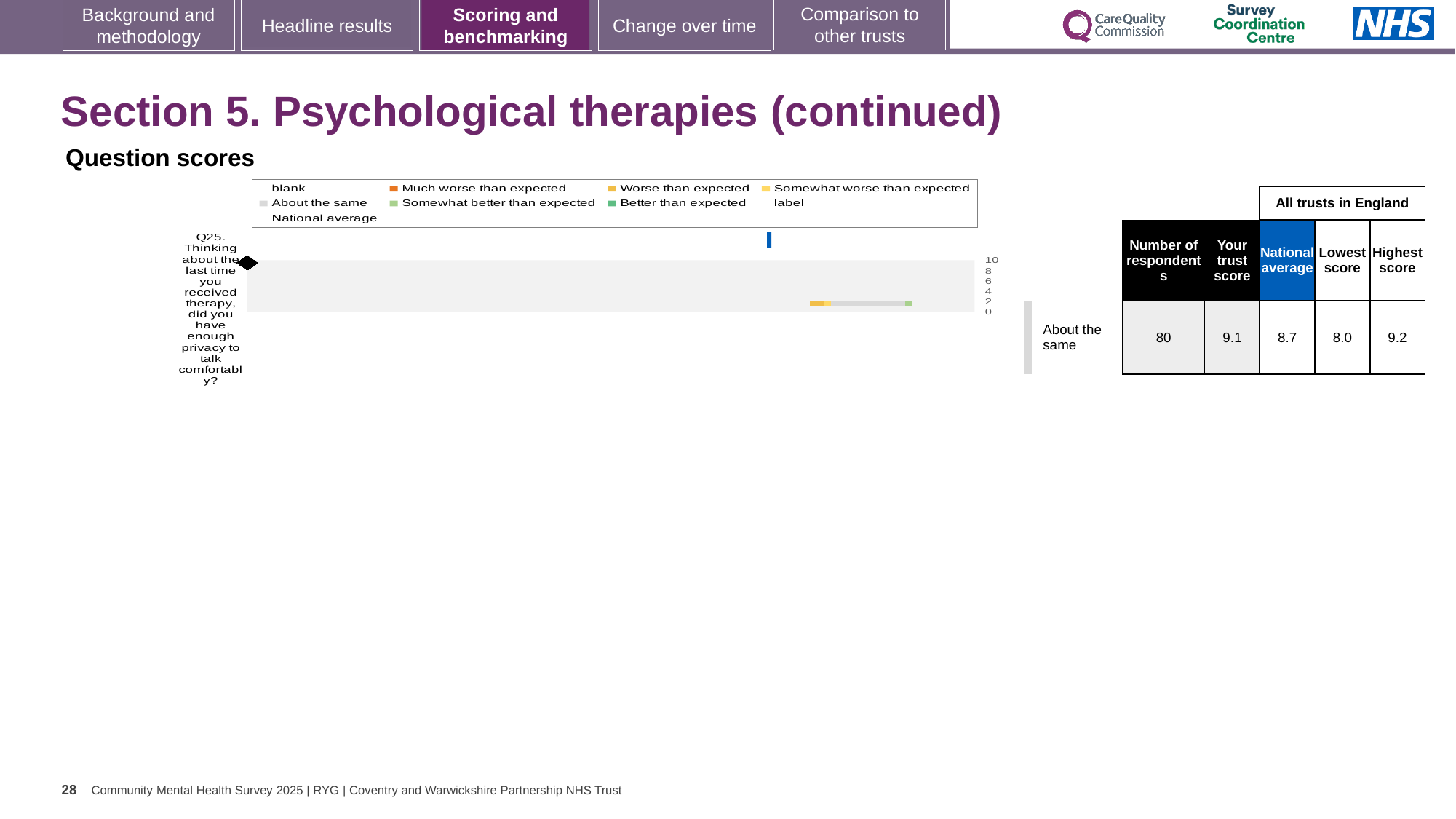
What is the difference between the highest and lowest scores for Q25 across all trusts in England? 1.2 What kind of chart is used to show the Q25 question score? bar chart What is the highest score among all trusts in England for Q25? 9.2 Which benchmarking category is the trust's Q25 score placed in? About the same Which is larger for Q25: the trust's score or the national average? the trust's score By how much does the trust's score for Q25 exceed the national average? 0.4 What is the lowest score among all trusts in England for Q25? 8.0 What is the trust's score for Q25 (privacy to talk comfortably during therapy)? 9.1 How many questions are plotted on the chart? 1 What is the national average score for Q25? 8.7 What is the maximum value shown on the chart's score axis? 10 How many respondents answered Q25? 80